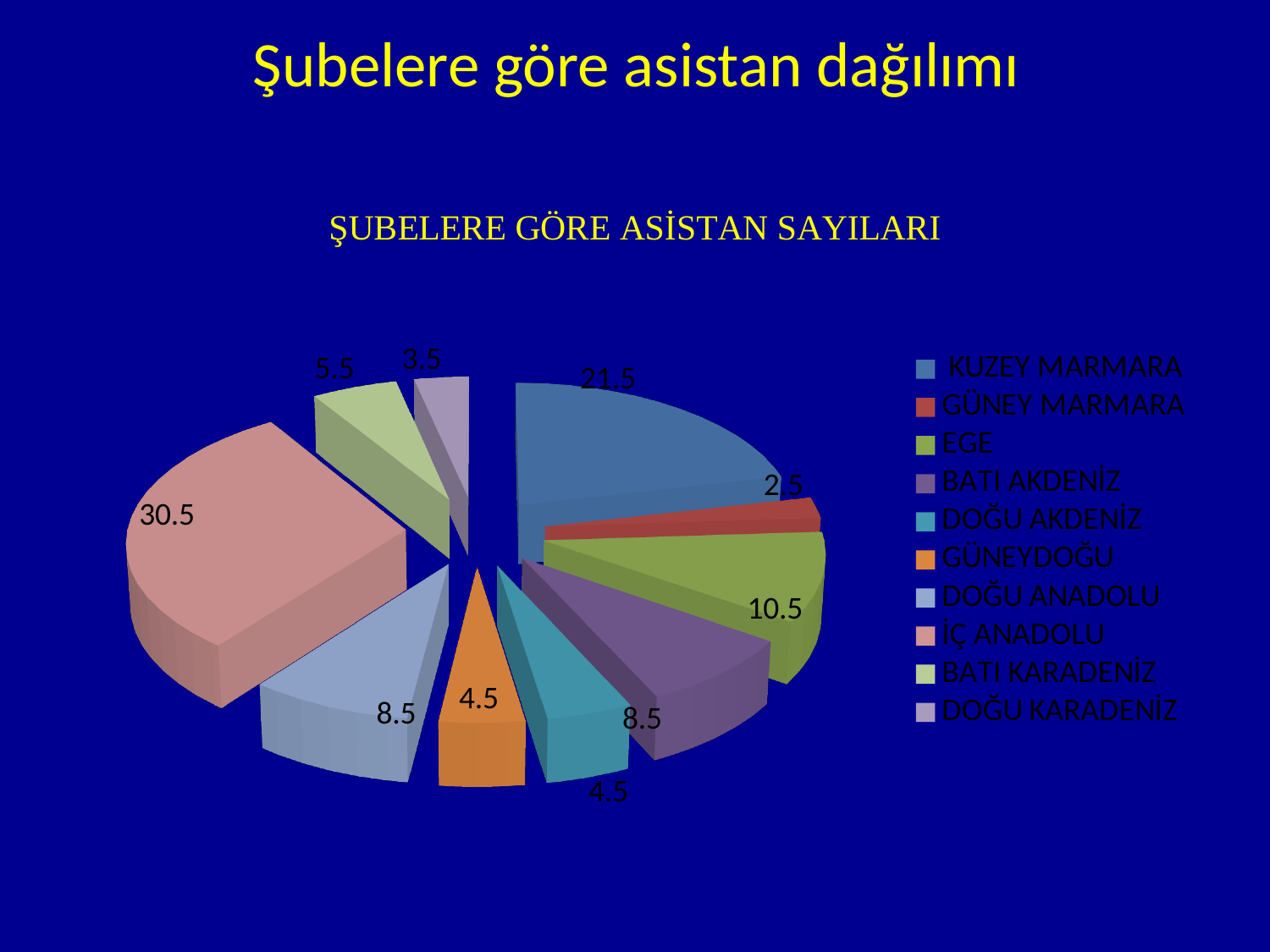
What is the value for KUZEY MARMARA? 21.5 What is the value for İÇ ANADOLU? 30.5 What is the value for GÜNEY MARMARA? 2.5 What is the value for EGE? 10.5 What is the value for DOĞU KARADENİZ? 3.5 Which category has the smallest slice of the pie? GÜNEY MARMARA Which is larger, the value for EGE or the value for BATI KARADENİZ? EGE Which category has the largest slice of the pie? İÇ ANADOLU What is the title of the chart? ŞUBELERE GÖRE ASİSTAN SAYILARI What is the difference between the values for İÇ ANADOLU and KUZEY MARMARA? 9 How many categories does the legend list? 10 What kind of chart is shown on the slide? pie chart